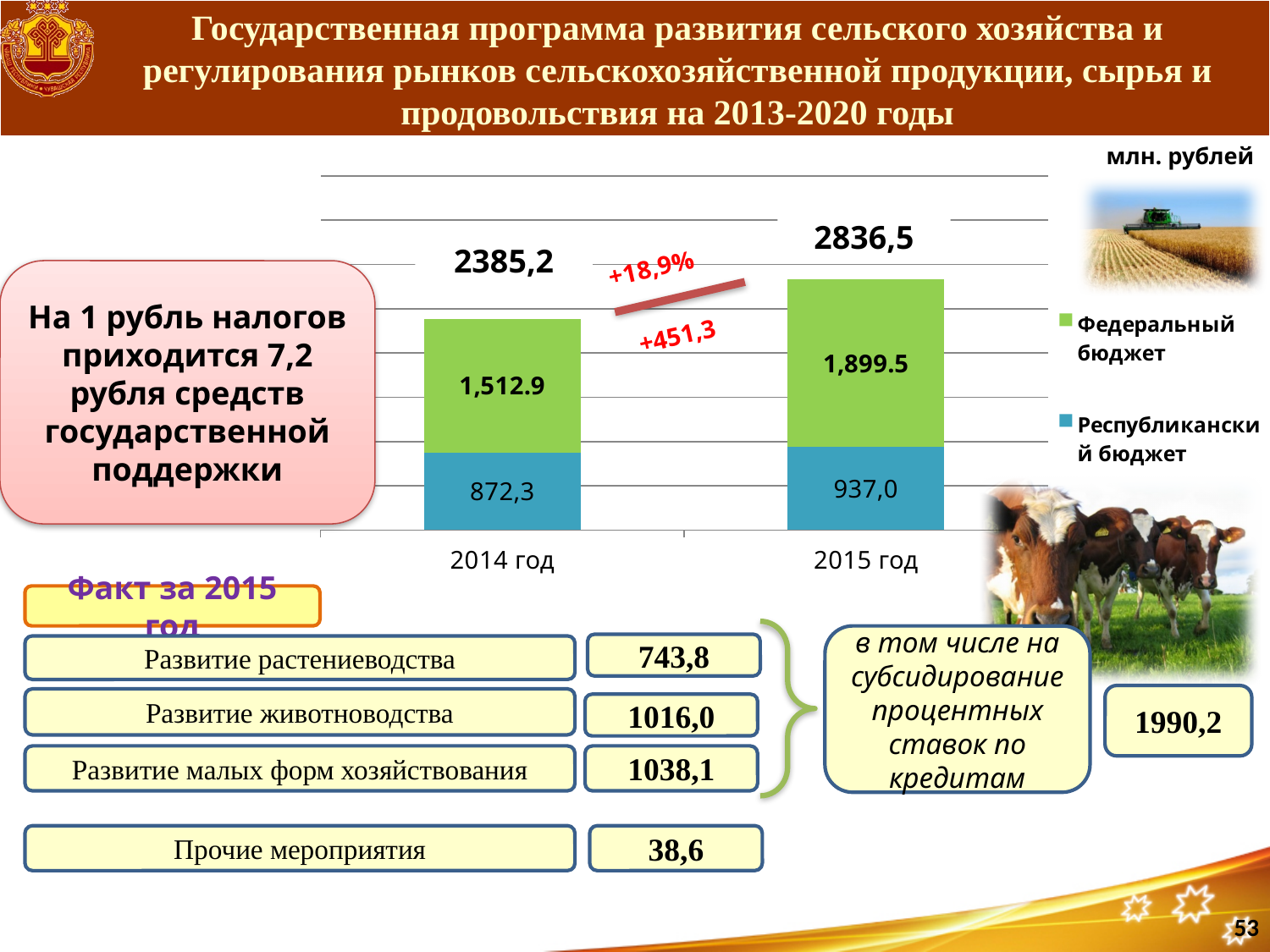
What is the difference between the Республиканский бюджет values for 2015 год and 2014 год? 64,7 Which year has the higher value for Федеральный бюджет, 2014 год or 2015 год? 2015 год What is the value of Республиканский бюджет for 2014 год? 872,3 What is the value of Федеральный бюджет for 2014 год? 1,512.9 What is the value of Республиканский бюджет for 2015 год? 937,0 What is the total of the stacked bar for 2014 год? 2385,2 Do the total values rise or fall from 2014 год to 2015 год? rise What unit is indicated for the chart values in the top right corner? млн. рублей How many categories (years) are shown on the x axis of the chart? 2 How many series does the chart legend list? 2 What is the total of the stacked bar for 2015 год? 2836,5 What kind of chart is shown on the slide? stacked bar chart